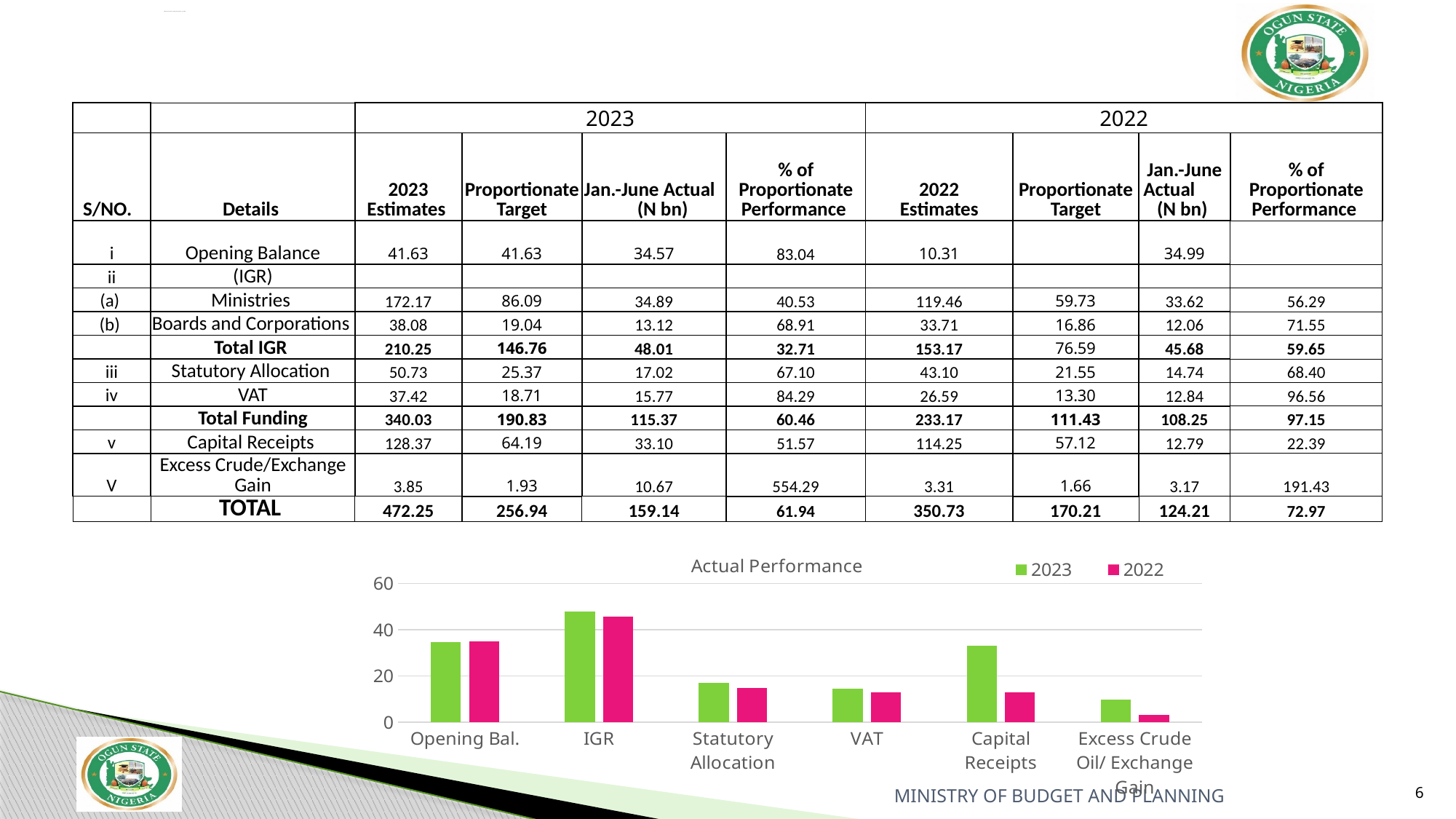
In the Actual Performance chart, is the 2023 value for IGR greater or less than 40? greater In the Actual Performance chart, is the 2023 value for Opening Bal. greater or less than 40? less In the Actual Performance chart, which category has the lowest 2022 bar? Excess Crude Oil/ Exchange Gain What kind of chart is shown under the table on the slide? Bar chart In the Actual Performance chart, which category has the highest 2023 bar? IGR In the Actual Performance chart, which is larger for Capital Receipts, the 2023 bar or the 2022 bar? 2023 In the Actual Performance chart, which colour represents the 2022 series? Pink In the Actual Performance chart, which category has the lowest 2023 bar? Excess Crude Oil/ Exchange Gain What is the title of the chart on the slide? Actual Performance In the Actual Performance chart, is the 2022 value for Capital Receipts greater or less than 20? less How many series does the legend of the Actual Performance chart list? 2 How many categories are shown on the x axis of the Actual Performance chart? 6